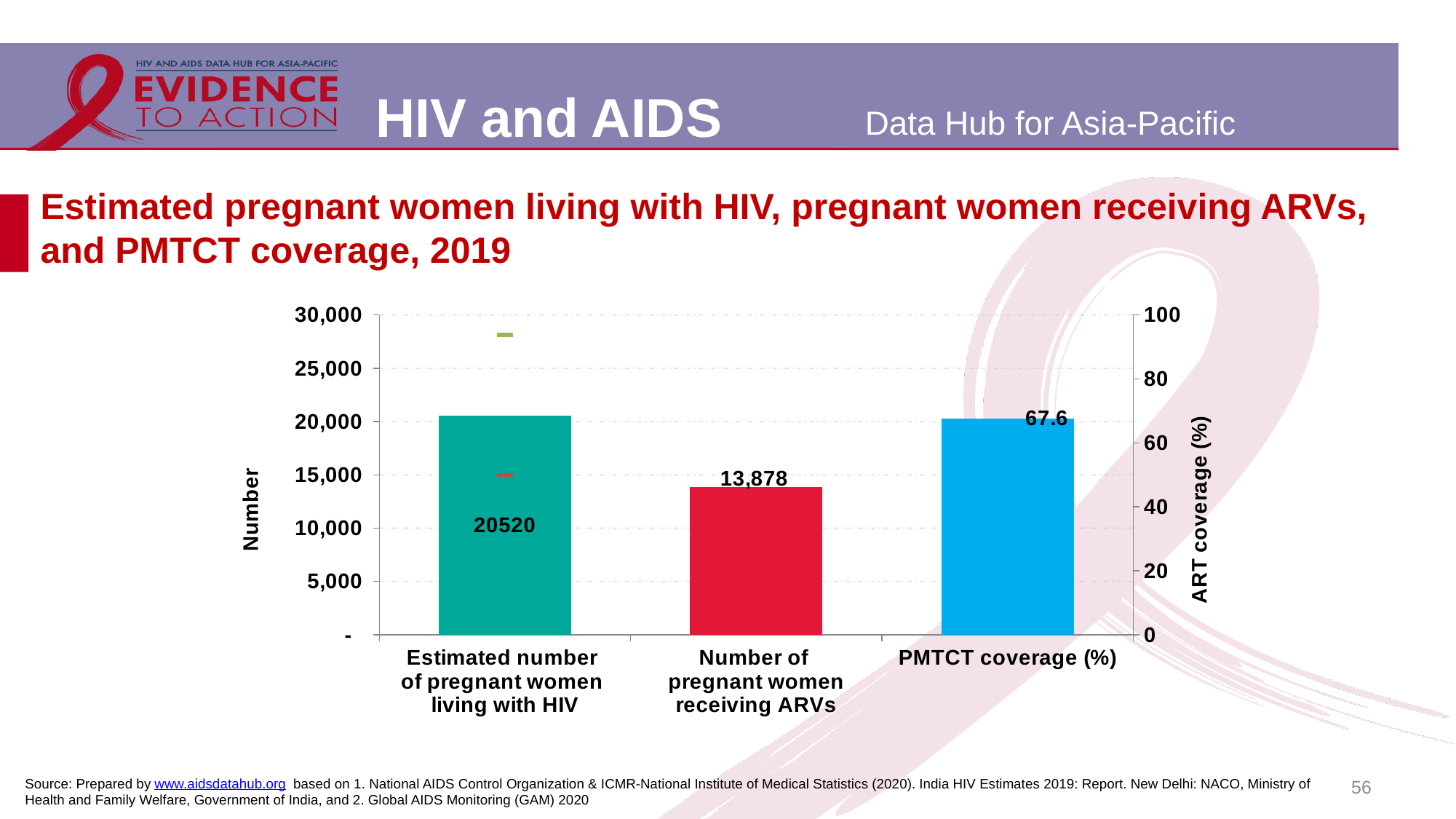
What kind of chart is shown on the slide? Bar chart What is the title of the right vertical axis of the chart? ART coverage (%) What is the difference between the estimated number of pregnant women living with HIV and the number of pregnant women receiving ARVs? 6,642 How many categories are plotted on the x axis of the chart? 3 Is the number of pregnant women receiving ARVs greater or less than 15,000? less Which is larger: the estimated number of pregnant women living with HIV or the number of pregnant women receiving ARVs? Estimated number of pregnant women living with HIV What is the maximum value shown on the left vertical axis of the chart? 30,000 Is the PMTCT coverage (%) value greater or less than 60 on the right-hand axis? greater What is the number of pregnant women receiving ARVs shown on the chart? 13,878 What is the title of the left vertical axis of the chart? Number What is the estimated number of pregnant women living with HIV shown on the chart? 20520 What is the PMTCT coverage (%) value shown on the chart? 67.6